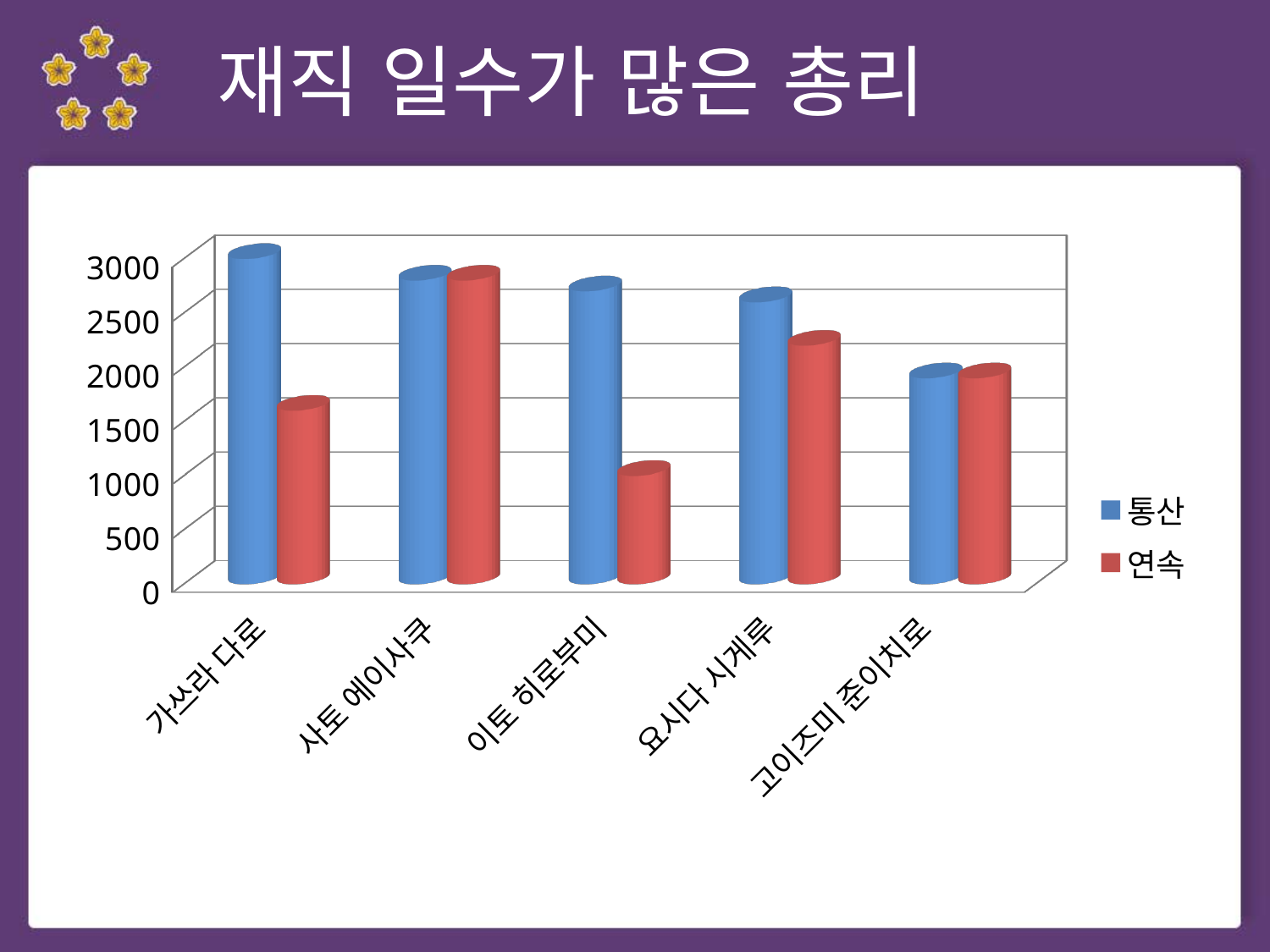
Is the 통산 value for 고이즈미 준이치로 greater or less than 2500? less How many categories (prime ministers) are shown on the x axis? 5 Is the 통산 value for 가쓰라 다로 greater or less than 2500? greater Is the 연속 value for 이토 히로부미 greater or less than 1500? less Which category has the highest 통산 value? 가쓰라 다로 How many series does the legend list? 2 Which category has the lowest 연속 value? 이토 히로부미 What kind of chart is shown on the slide? bar chart Which category has the highest 연속 value? 사토 에이사쿠 What is the title of the slide? 재직 일수가 많은 총리 Do the 통산 values rise or fall from left to right across the x axis? fall For 이토 히로부미, which is larger, 통산 or 연속? 통산